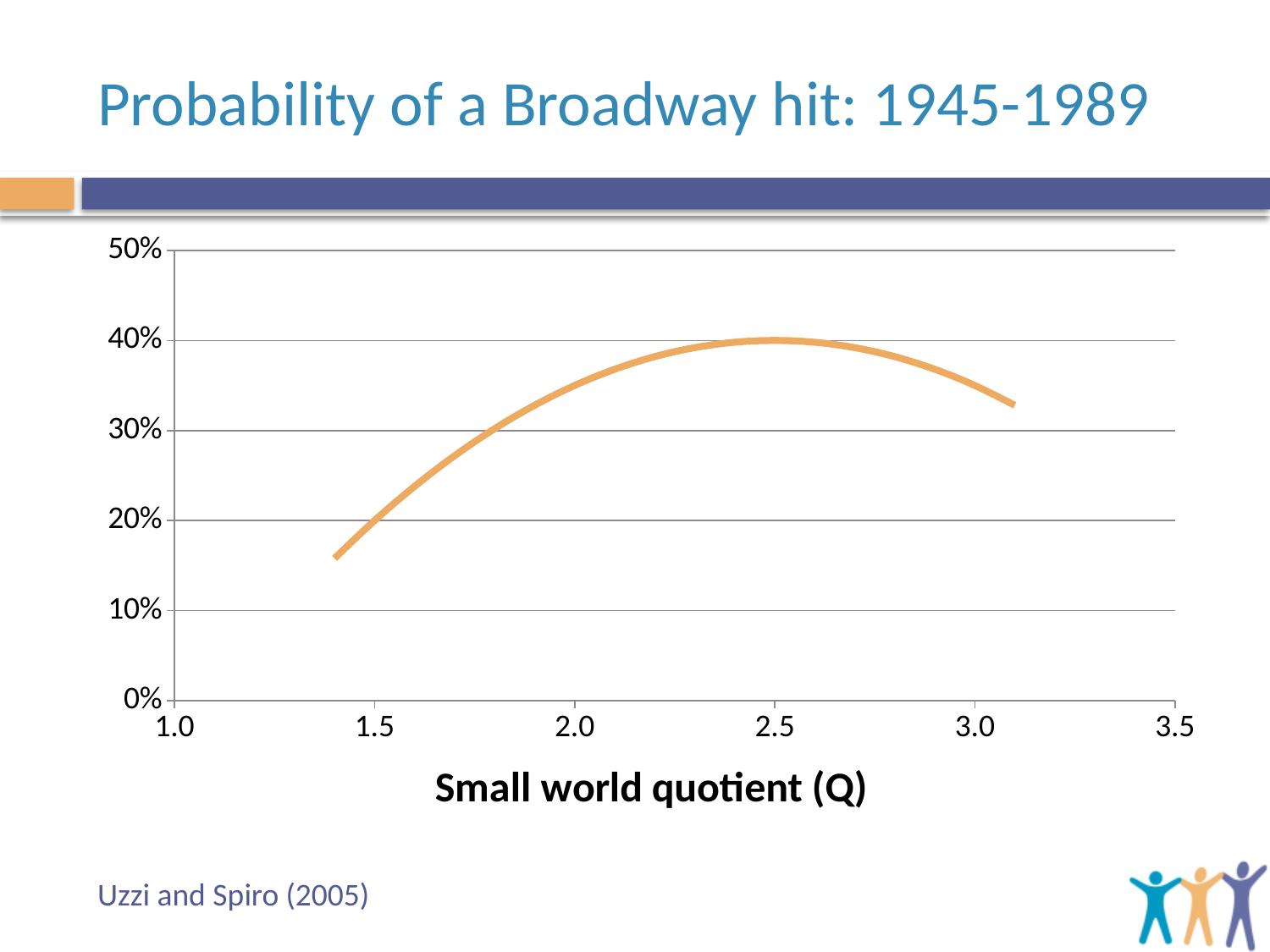
Is the value of the curve at Q = 3.0 greater or less than 30%? greater What is the label of the x axis? Small world quotient (Q) Does the curve rise or fall as Q increases from 1.5 to 2.5? rise What is the title of the chart on the slide? Probability of a Broadway hit: 1945-1989 Does the curve rise or fall as Q increases from 2.5 to 3.0? fall What kind of chart is shown on the slide? line chart Is the value of the curve at Q = 2.5 greater or less than 30%? greater Is the value of the curve at Q = 2.5 greater or less than 50%? less Which is larger, the value of the curve at Q = 2.0 or at Q = 1.5? Q = 2.0 At which x-axis tick value does the curve reach its highest point? 2.5